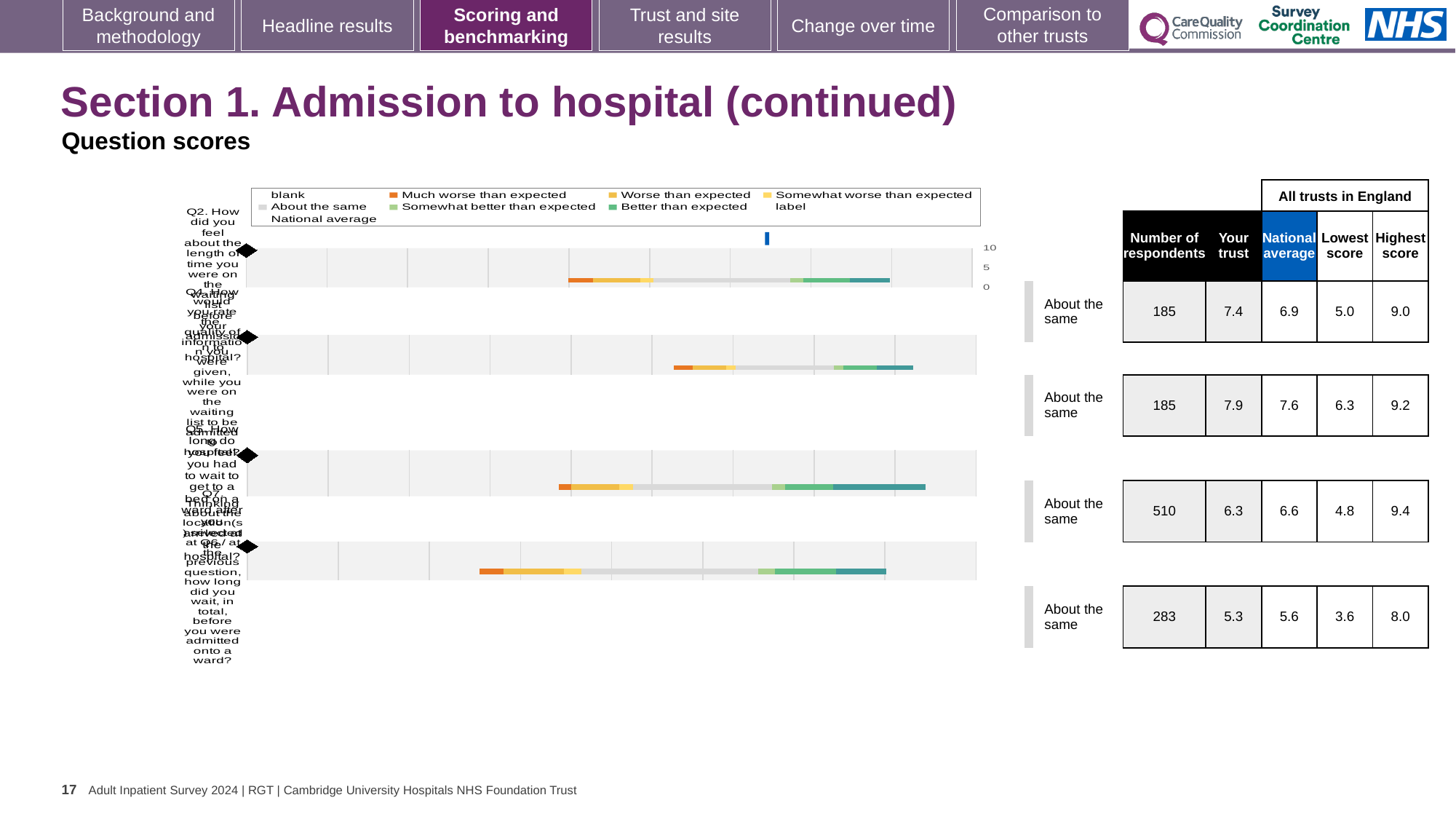
Which colour does the legend use for 'Much worse than expected'? orange What is the difference between the highest score and the lowest score for the second question (Q4) in the table? 2.9 Which question has the lowest 'Your trust' score in the table beside the chart? Q7 Is the 'Your trust' score for Q2 larger or smaller than its national average? larger What is the highest value shown on the chart's axis? 10 According to the table beside the chart, what is the national average for the third question (Q5)? 6.6 What kind of chart is shown on the slide? bar chart How many question bars are plotted in the chart? 4 Which question has the highest 'Your trust' score in the table beside the chart? Q4 What benchmark category is shown for every question on the slide? About the same According to the table beside the chart, how many respondents answered the fourth question (Q7)? 283 According to the table beside the chart, what is the 'Your trust' score for the first question (Q2)? 7.4